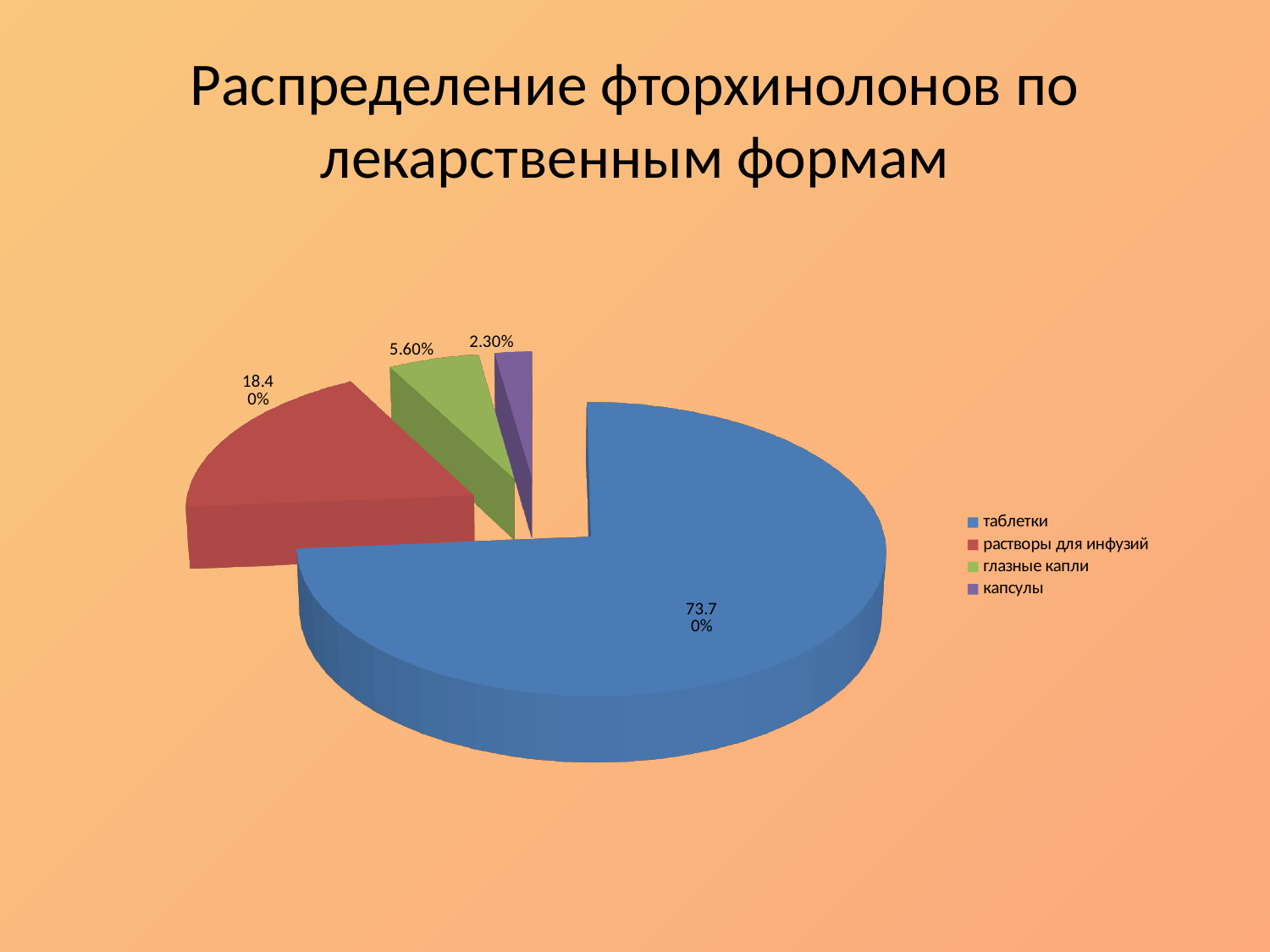
What colour is the slice for капсулы? purple How many categories does the legend list? 4 Which category has the smallest slice of the pie? капсулы What is the title of the chart? Распределение фторхинолонов по лекарственным формам What share of the pie does глазные капли have? 5.60% What share of the pie does капсулы have? 2.30% What is the difference in percentage points between the share for таблетки and the share for растворы для инфузий? 55.30% Which is larger, the share for растворы для инфузий or the share for глазные капли? растворы для инфузий What share of the pie does таблетки have? 73.70% Which category has the largest slice of the pie? таблетки What type of chart is shown on the slide? pie chart What share of the pie does растворы для инфузий have? 18.40%